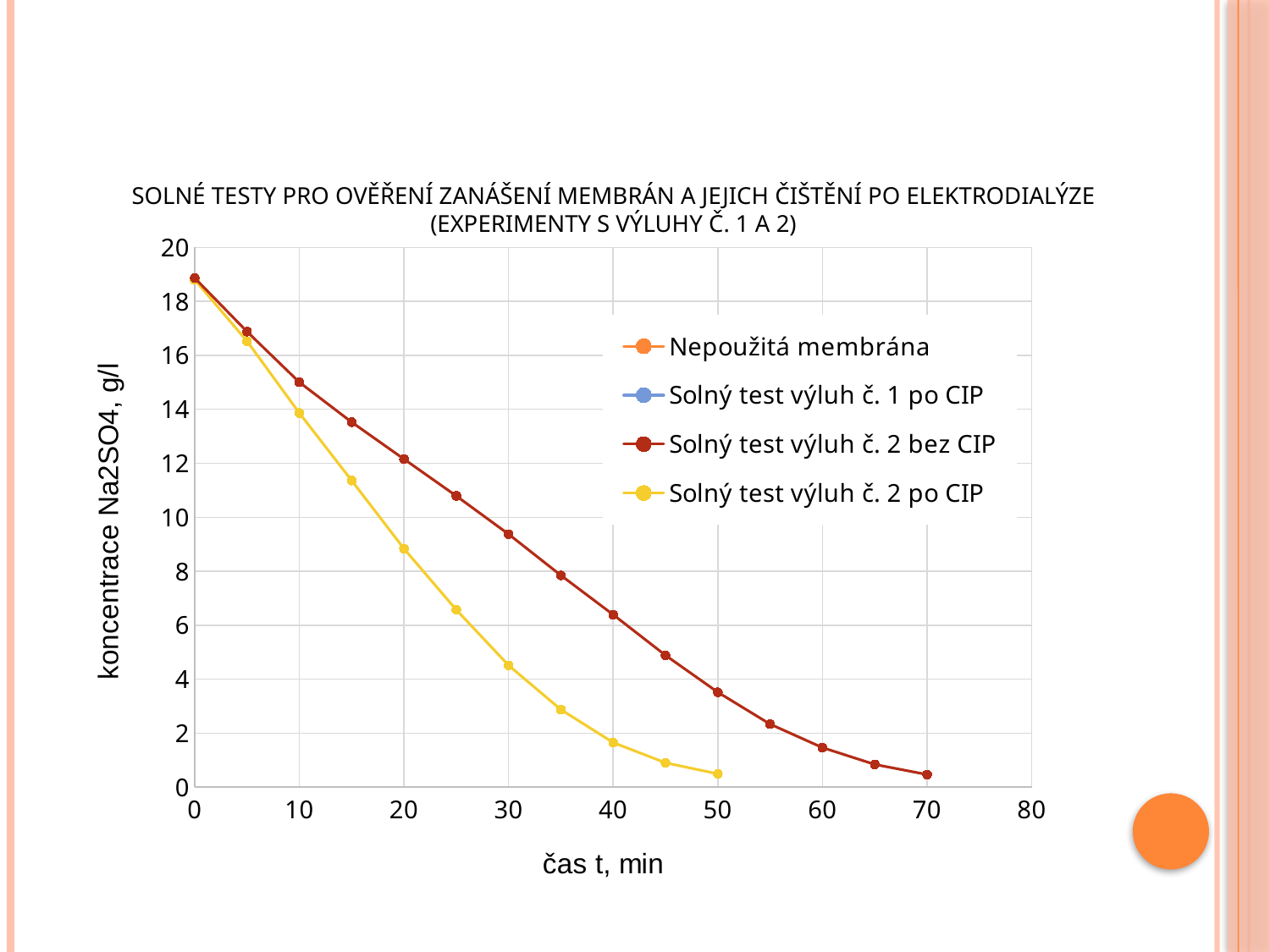
Is the value of 'Solný test výluh č. 2 po CIP' at 30 min greater or less than 6? less How many data points are plotted for the 'Solný test výluh č. 2 bez CIP' series? 15 Is the value of 'Solný test výluh č. 2 po CIP' at 20 min greater or less than 10? less What is the title of the vertical axis? koncentrace Na2SO4, g/l At 30 min, which series has the higher concentration: 'Solný test výluh č. 2 bez CIP' or 'Solný test výluh č. 2 po CIP'? Solný test výluh č. 2 bez CIP How many series does the legend list? 4 Is the value of 'Solný test výluh č. 2 bez CIP' at 50 min greater or less than 2? greater Do the values of the 'Solný test výluh č. 2 bez CIP' series rise or fall as time increases? fall What is the title of the horizontal axis? čas t, min What kind of chart is shown on the slide? line chart